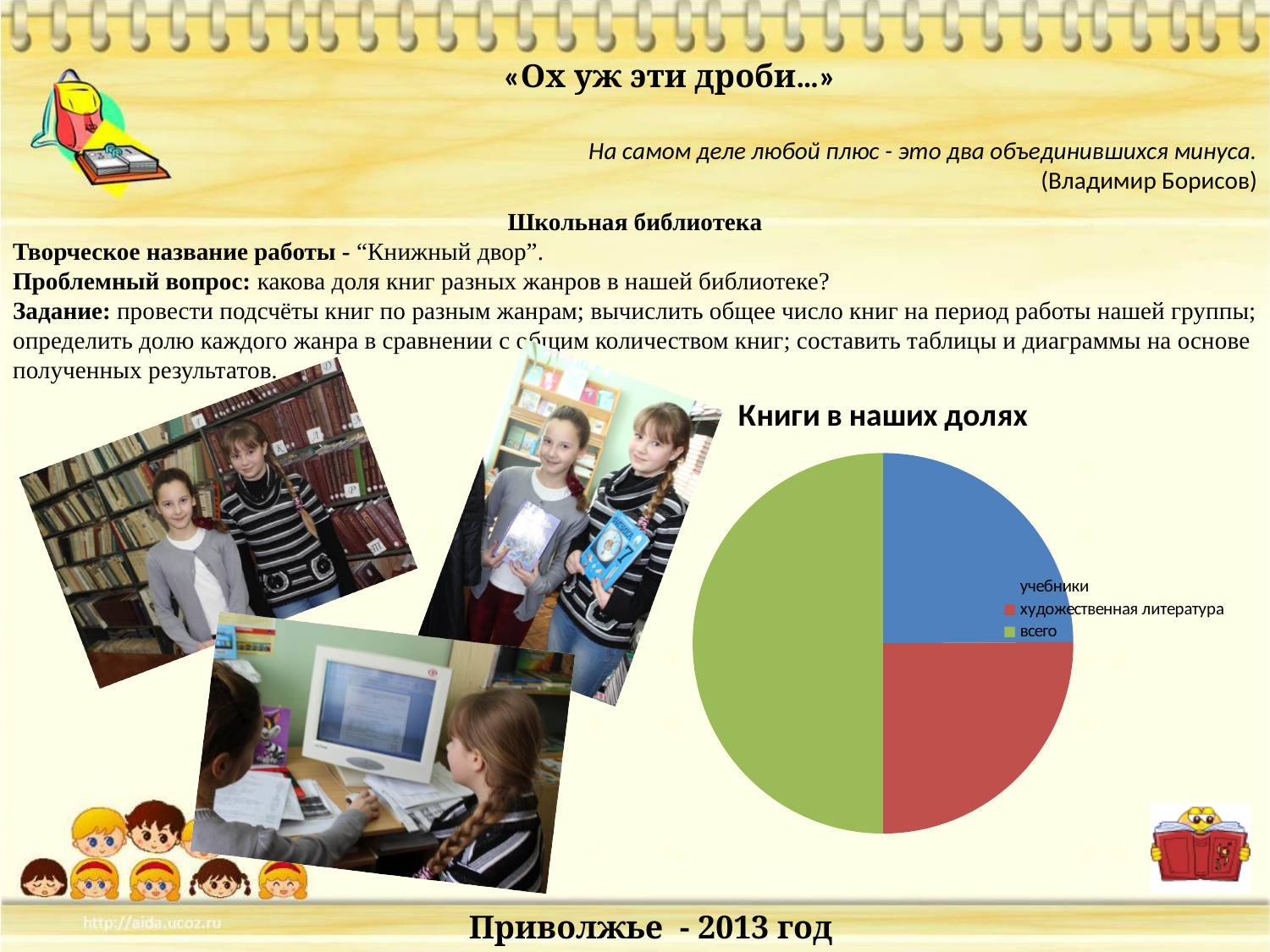
Which slice is larger: всего or художественная литература? всего How many entries does the chart's legend list? 3 What kind of chart is shown on the slide? pie chart Which category has the largest slice in the pie chart? всего Which category is shown in blue in the pie chart? учебники Which slice is larger: всего or учебники? всего Which category is shown in red in the pie chart? художественная литература What is the title of the chart on the slide? Книги в наших долях What colour is the slice for всего in the pie chart? green How many slices does the pie chart have? 3